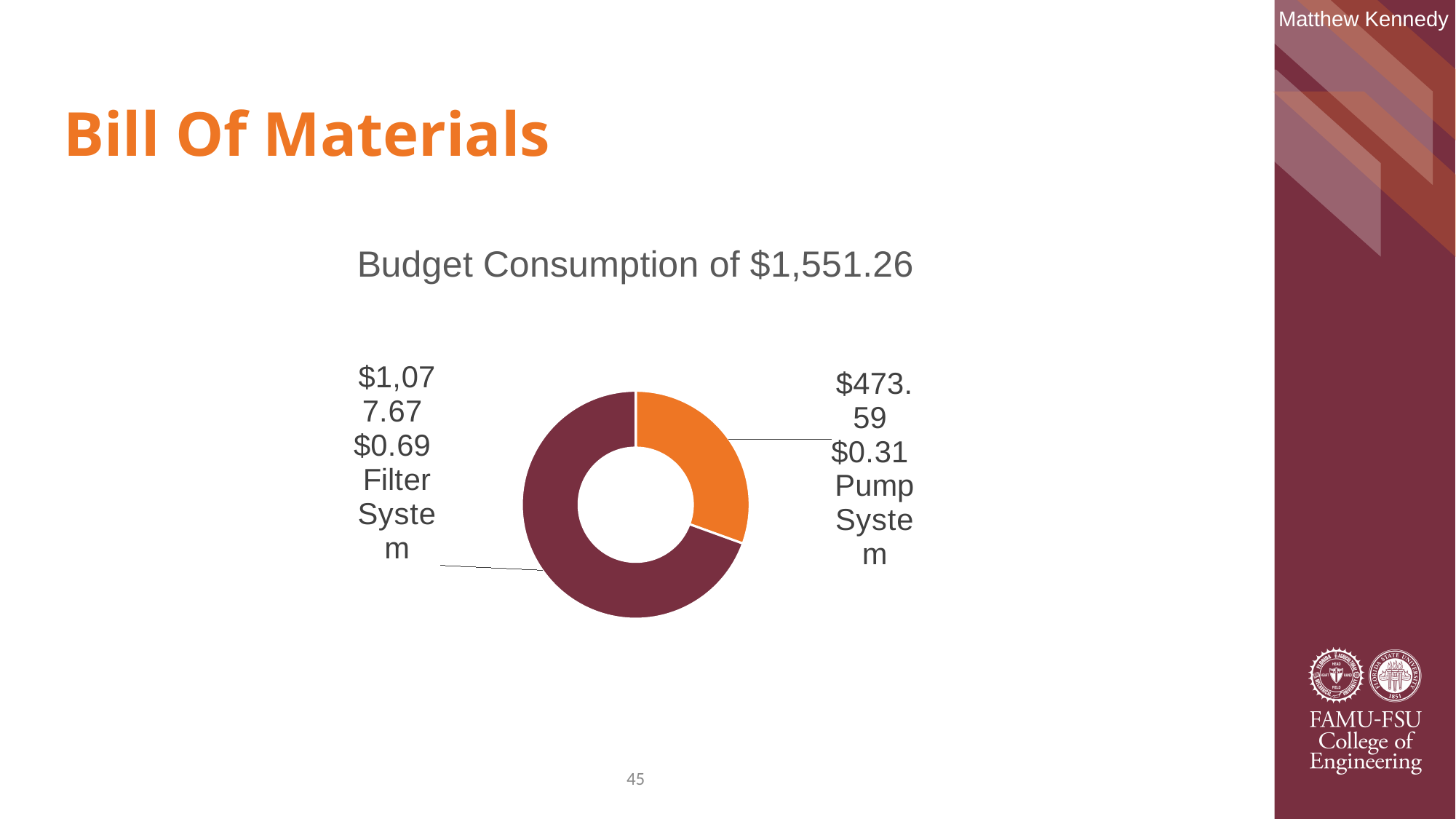
What is the dollar value shown for the Pump System? $473.59 How many categories does the chart show? 2 Which category has the largest share of the budget? Filter System Which category has the smallest share of the budget? Pump System What is the title of the chart? Budget Consumption of $1,551.26 What colour is the Pump System slice? orange Which is larger, the Filter System cost or the Pump System cost? Filter System What share label is printed for the Pump System slice? $0.31 What is the dollar value shown for the Filter System? $1,077.67 What type of chart is shown on the slide? doughnut chart What share label is printed for the Filter System slice? $0.69 What is the difference between the Filter System cost and the Pump System cost? $604.08